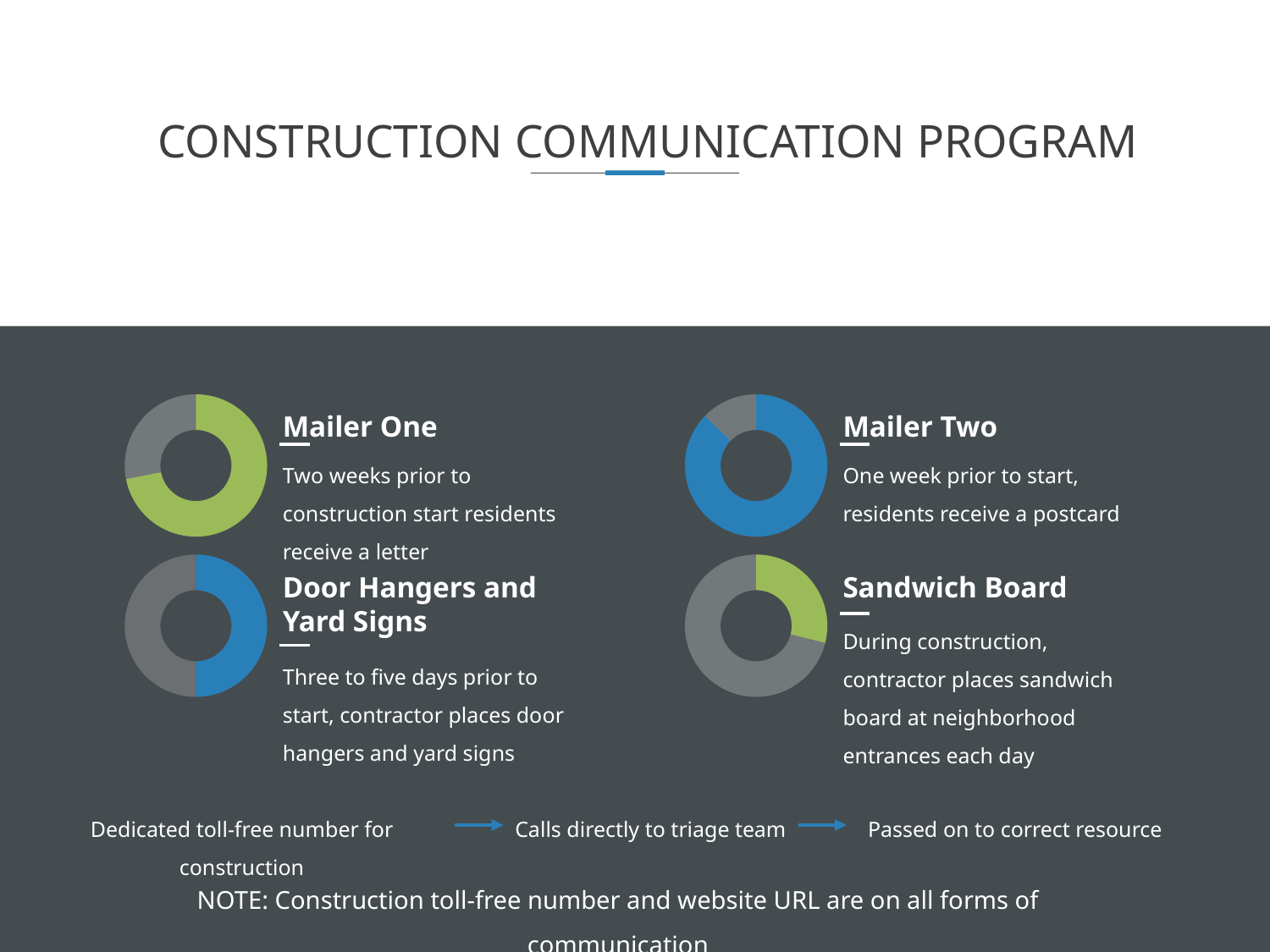
In the donut chart next to 'Mailer One', which slice is larger, the green slice or the grey slice? the green slice How many slices does the donut chart next to 'Door Hangers and Yard Signs' have? 2 How many slices does the donut chart next to 'Mailer Two' have? 2 What kind of chart is shown next to the heading 'Sandwich Board'? donut chart How many donut charts are on the slide? 4 What colour is the non-grey slice in the donut chart next to 'Sandwich Board'? green What kind of chart is shown next to the heading 'Mailer One'? donut chart In the donut chart next to 'Mailer Two', which slice is larger, the blue slice or the grey slice? the blue slice What colour is the larger slice in the donut chart next to 'Mailer Two'? blue In the donut chart next to 'Sandwich Board', which slice is larger, the green slice or the grey slice? the grey slice